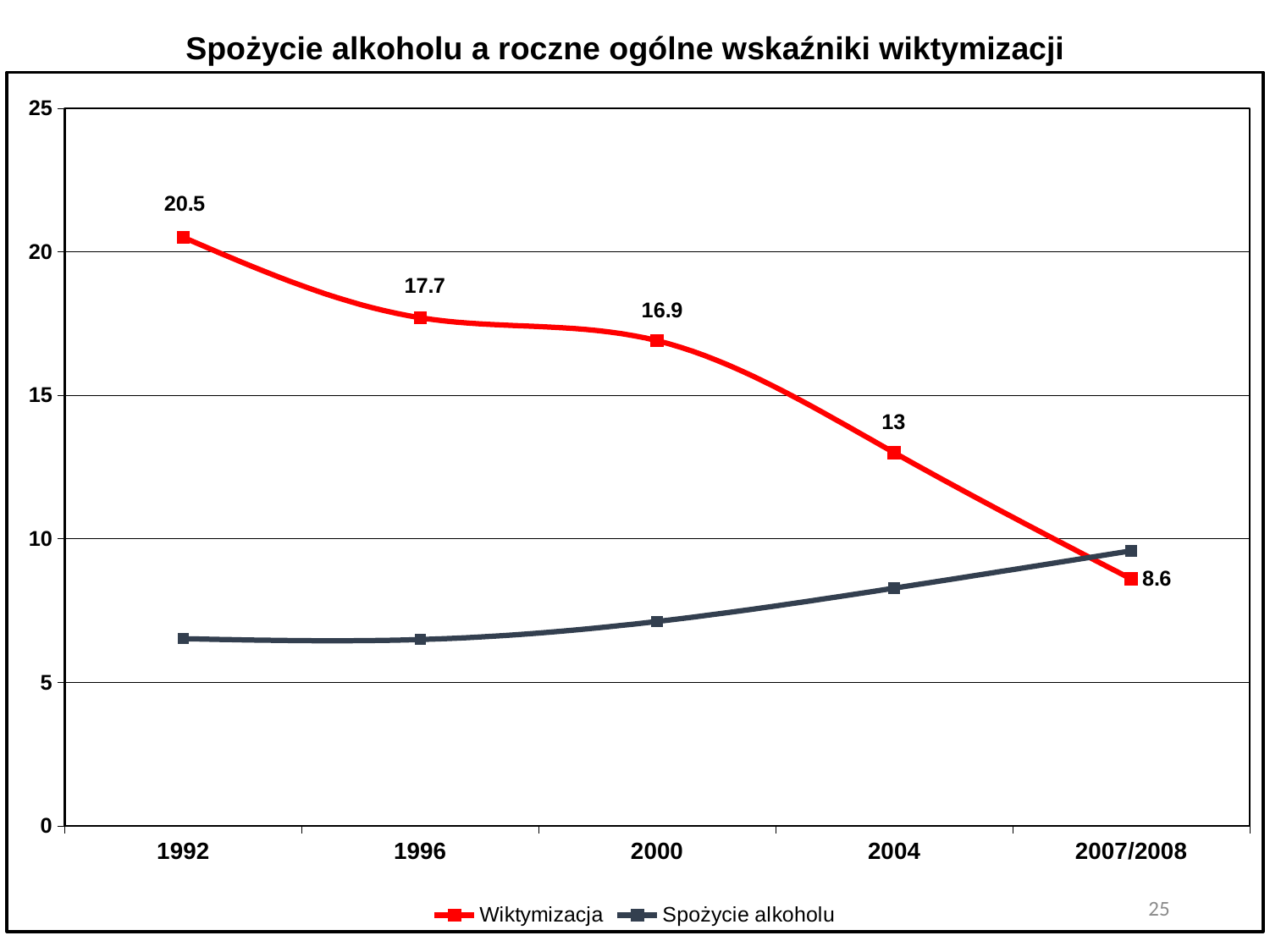
What is the difference between the Wiktymizacja values for 1996 and 2000? 0.8 How many series does the legend list? 2 What kind of chart is shown on the slide? Line chart Which series has the larger value in 2007/2008, Wiktymizacja or Spożycie alkoholu? Spożycie alkoholu Is the Spożycie alkoholu value for 1992 greater or less than 5? greater What is the Wiktymizacja value for 2004? 13 What is the Wiktymizacja value for 1992? 20.5 Is the Spożycie alkoholu value for 2004 greater or less than 10? less In which year is the Wiktymizacja value highest? 1992 How many time points are shown on the x axis? 5 In which year is the Wiktymizacja value lowest? 2007/2008 What is the Wiktymizacja value for 2007/2008? 8.6